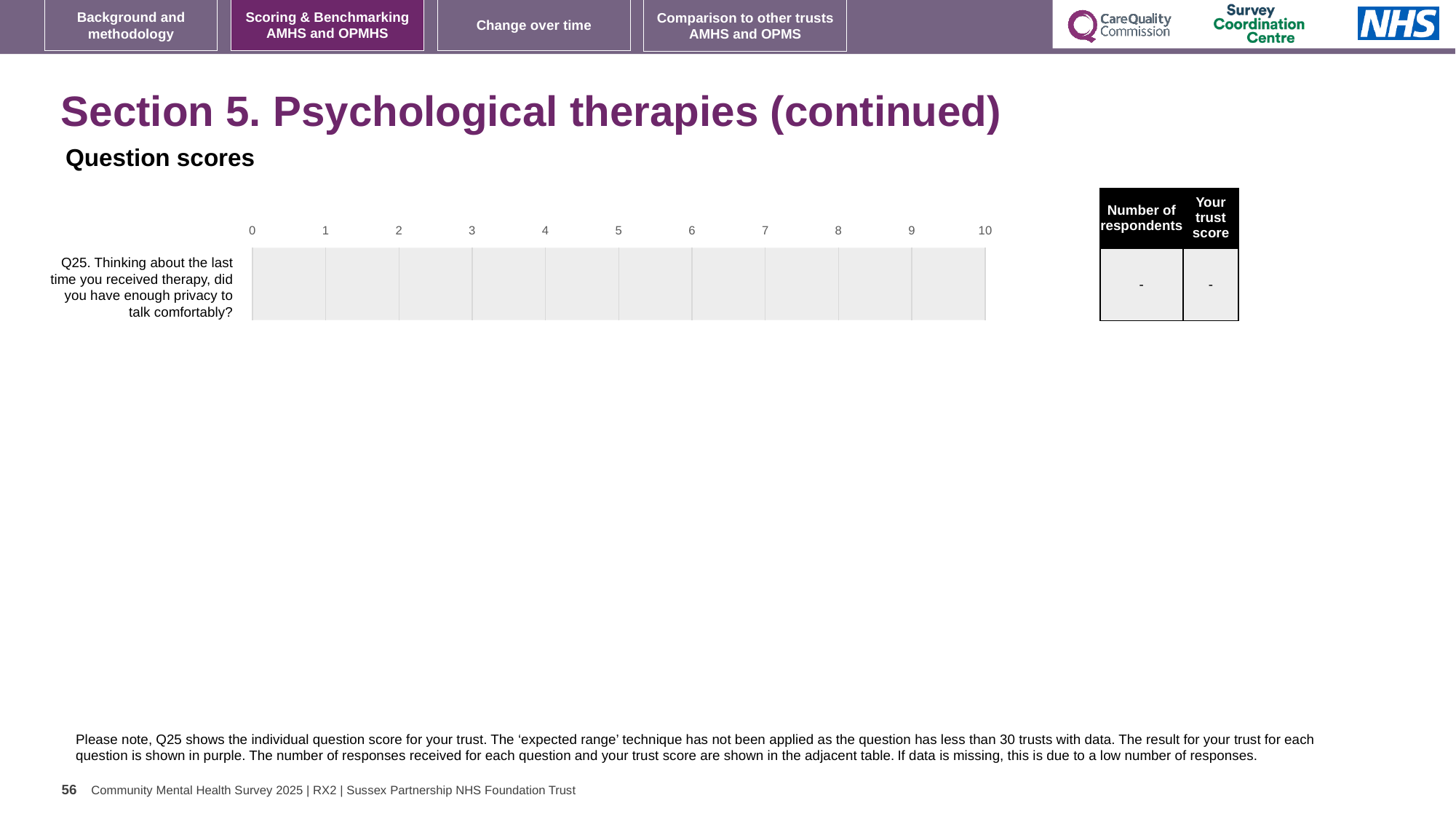
What is the trust score shown in the table for Q25? - How many questions (categories) are plotted on the chart? 1 What is the highest value shown on the chart's horizontal axis? 10 What is the number of respondents shown in the table for Q25? - What is the lowest value shown on the chart's horizontal axis? 0 Is a bar plotted for Q25 on the chart? No Which question number is plotted on the chart? Q25